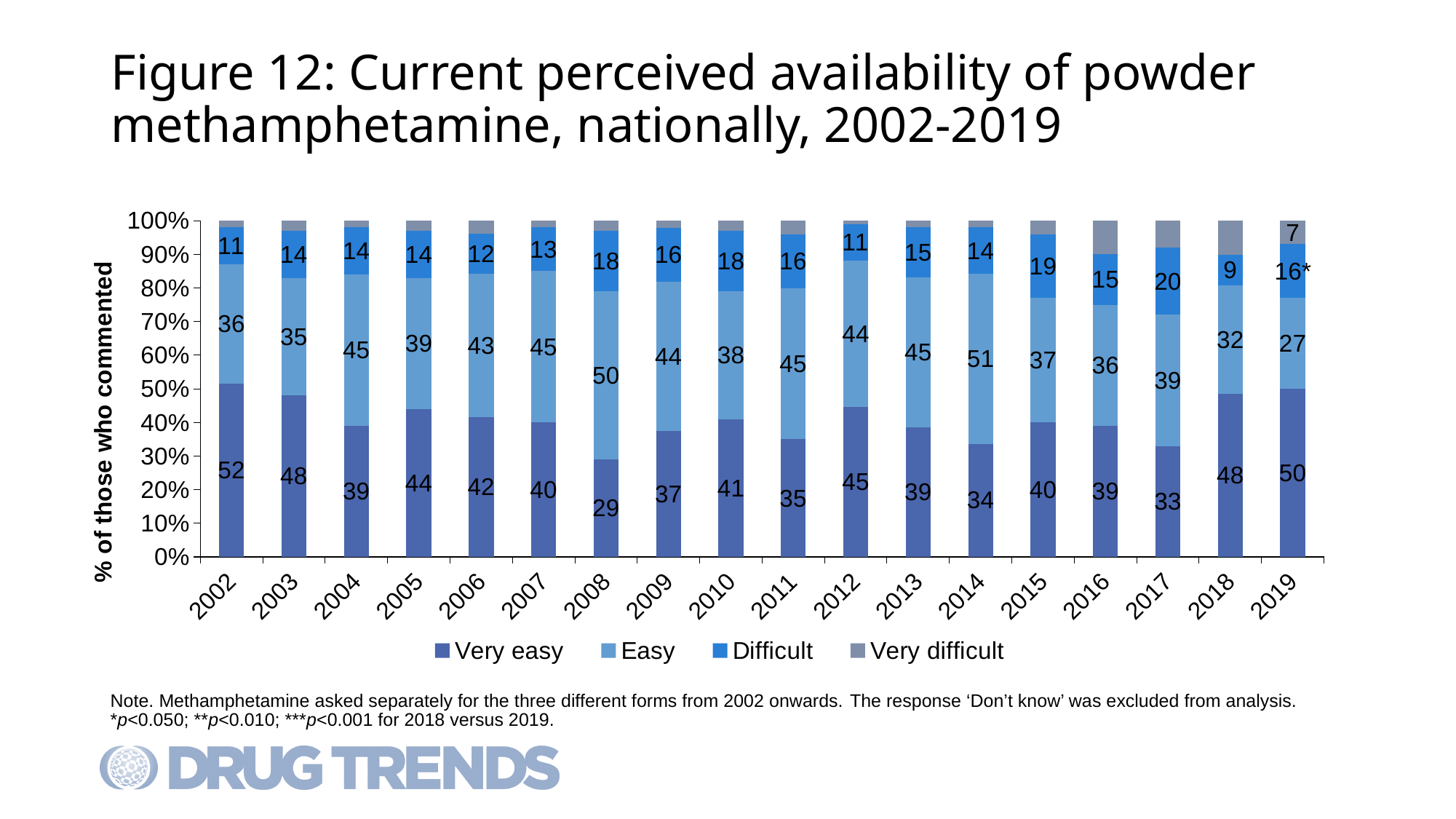
In which year is the 'Very easy' value lowest? 2008 How many years are shown on the x axis? 18 How many series does the legend list? 4 In which year is the 'Very easy' value highest? 2002 What is the difference between the 'Very easy' value in 2019 and in 2018? 2 What kind of chart is shown on the slide? Stacked bar chart What is the 'Difficult' value for 2017? 20 What is the 'Easy' value for 2014? 51 In which year is the 'Easy' value highest? 2014 Which year has the larger 'Easy' value, 2008 or 2019? 2008 What is the 'Very easy' value for 2002? 52 What is the 'Very difficult' value for 2019? 7